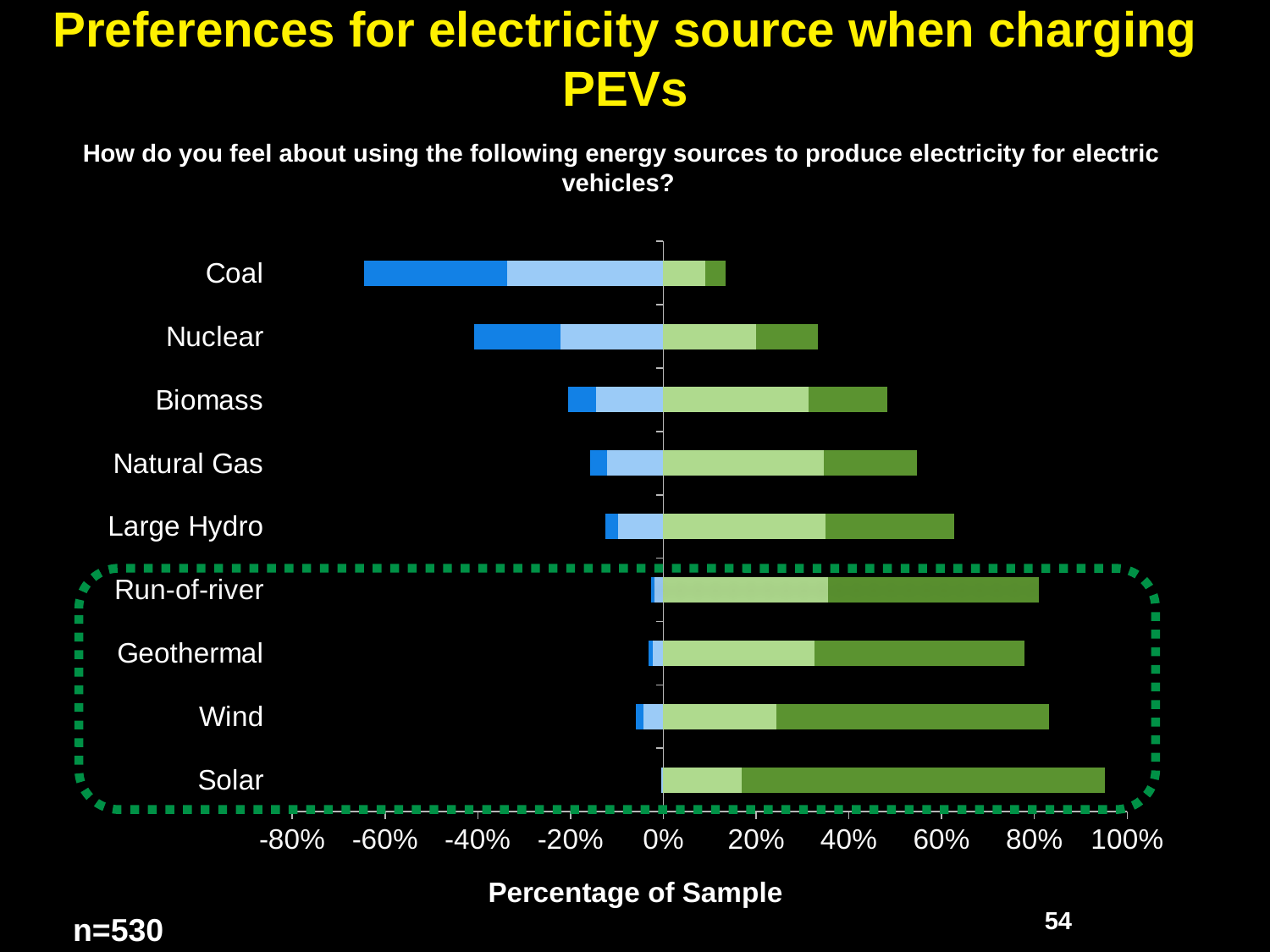
Which has a longer negative (blue) bar, Coal or Nuclear? Coal What is the title of the horizontal axis? Percentage of Sample Is the positive (green) portion of the Solar bar greater or less than 80%? greater Which energy source has the longest positive (green) bar? Solar Which energy source has the shortest positive (green) bar? Coal How many energy sources are listed as categories on the chart? 9 Which energy sources are enclosed by the dashed green box? Run-of-river, Geothermal, Wind, Solar Which energy source has the longest negative (blue) bar? Coal Is the positive (green) portion of the Coal bar greater or less than 20%? less Which has a longer positive (green) bar, Biomass or Large Hydro? Large Hydro Is the positive (green) portion of the Natural Gas bar greater or less than 60%? less What kind of chart is shown on the slide? Bar chart